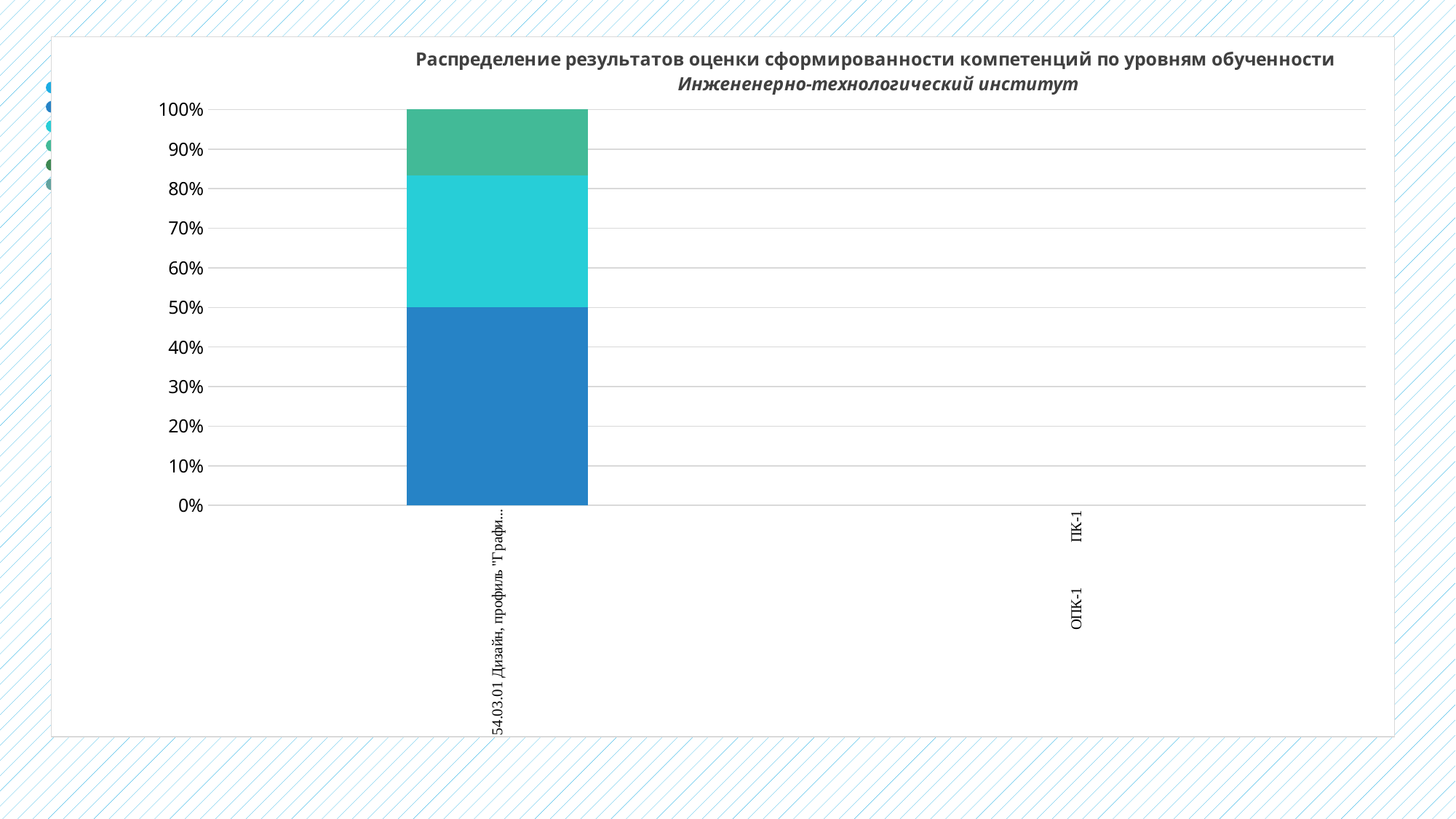
What is the total height of the stacked bar for 54.03.01 Дизайн? 100% At what value on the axis does the bottom (dark blue) segment of the stacked bar end? 50% Is the dark blue segment of the stacked bar greater or less than 40%? greater What is the title of the chart? Распределение результатов оценки сформированности компетенций по уровням обученности Is the top of the cyan (middle) segment of the stacked bar greater or less than 90%? less Is the top of the cyan (middle) segment of the stacked bar greater or less than 70%? greater Which segment of the stacked bar is the smallest: dark blue, cyan, or green? green Which institute is named in the chart's subtitle? Инжененерно-технологический институт What kind of chart is shown on the slide? stacked bar chart What is the highest value shown on the vertical axis? 100% Which segment of the stacked bar is the largest: dark blue, cyan, or green? dark blue